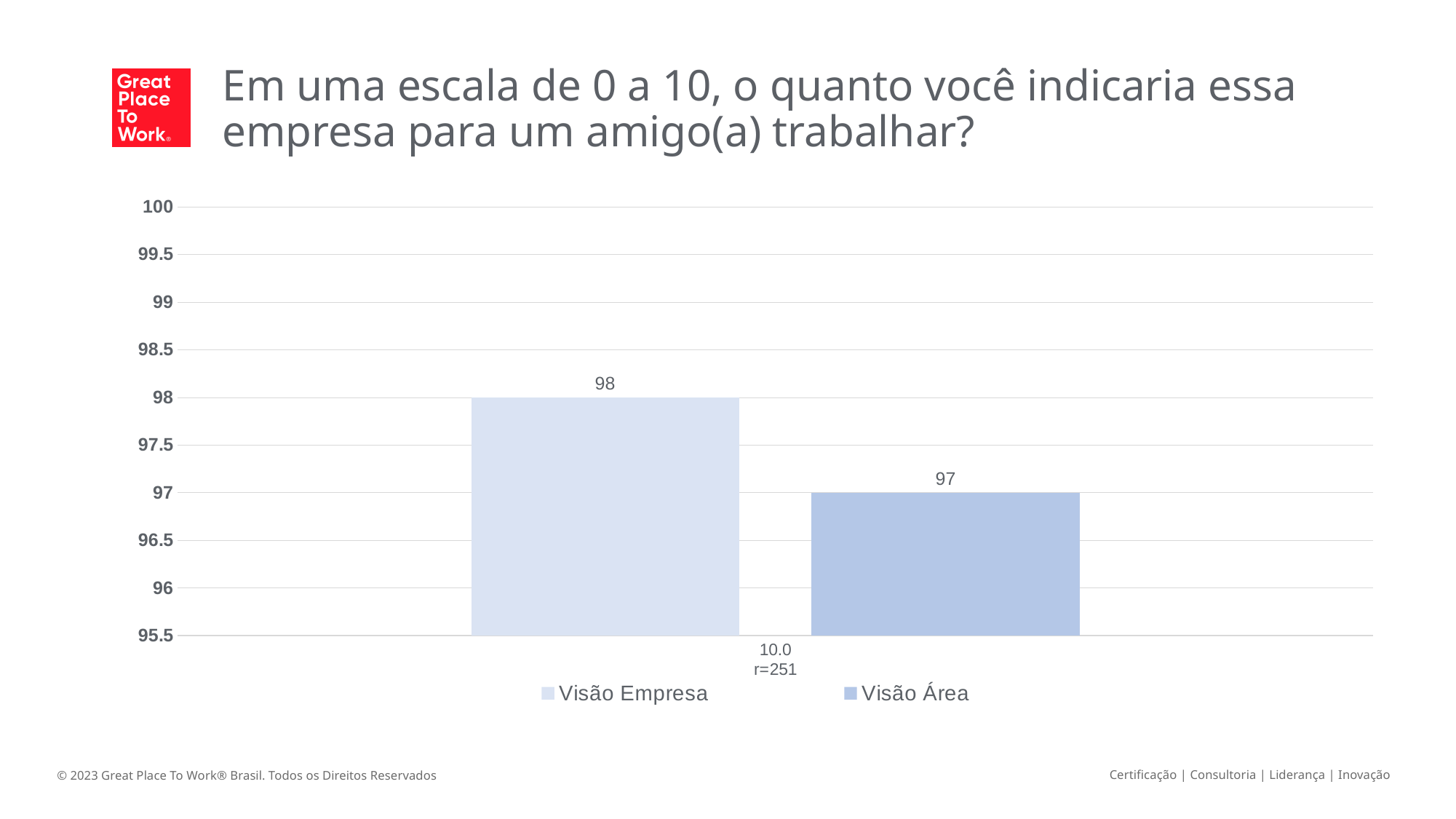
Which series has the lowest value? Visão Área Is the value for Visão Empresa greater or less than 97.5? greater What is the value for Visão Empresa? 98 How many bars are plotted in the chart? 2 Is the value for Visão Área greater or less than 97.5? less What kind of chart is shown on the slide? Bar chart How many series does the legend list? 2 What is the value for Visão Área? 97 Which series has the higher value, Visão Empresa or Visão Área? Visão Empresa What is the difference between the Visão Empresa and Visão Área values? 1 What is the category label shown below the bars on the x axis? 10.0 r=251 What is the highest value shown on the y axis? 100